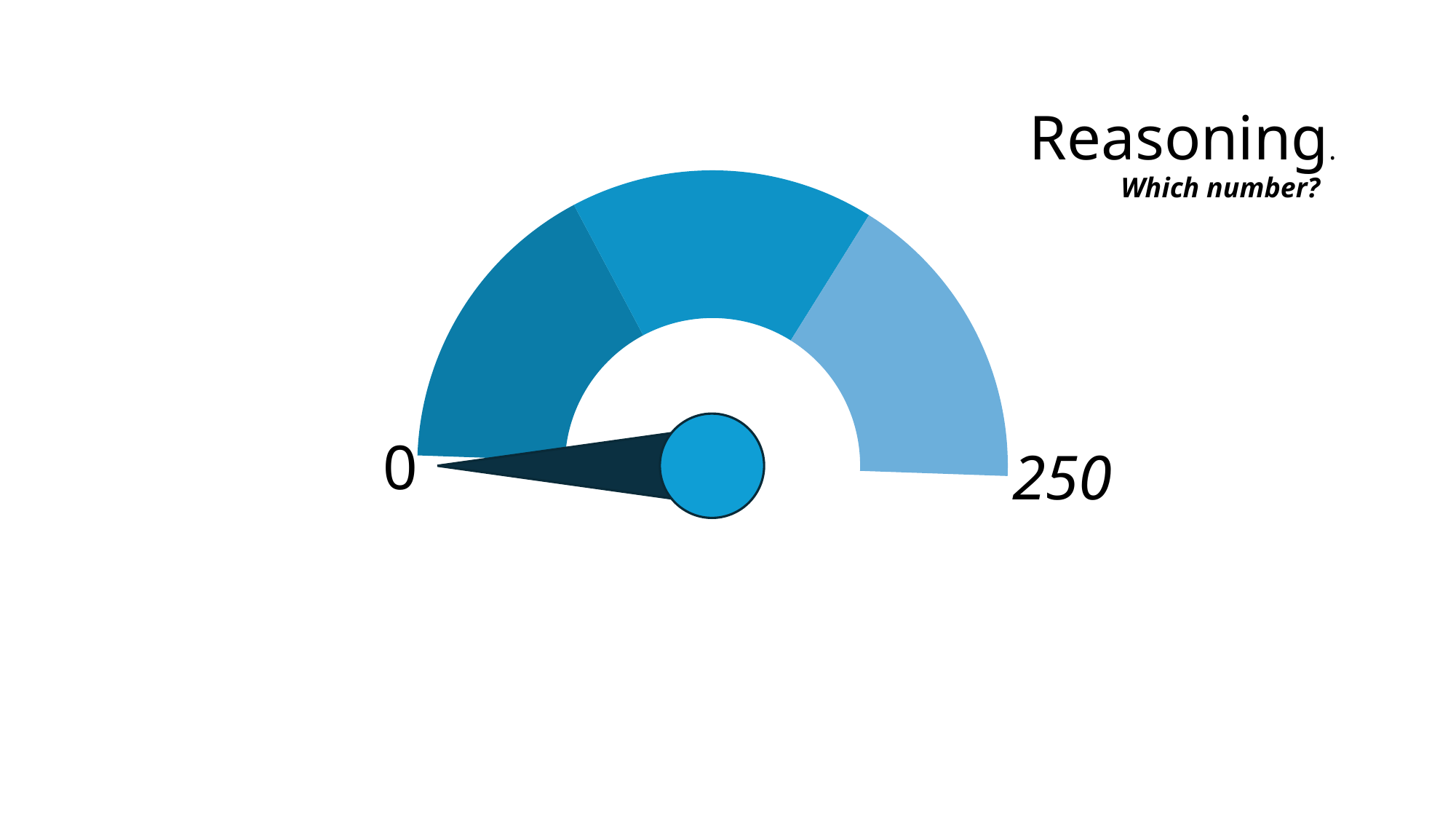
What is the title of the chart? Reasoning. What kind of chart is shown on the slide? gauge chart What subtitle appears under the chart title? Which number? How many coloured segments make up the gauge arc? 3 Which end of the gauge scale does the needle point to, the 0 end or the 250 end? 0 What is the maximum value shown on the gauge scale? 250 What value does the needle of the gauge point to? 0 Is the value indicated by the needle greater or less than 250? less What is the minimum value shown on the gauge scale? 0